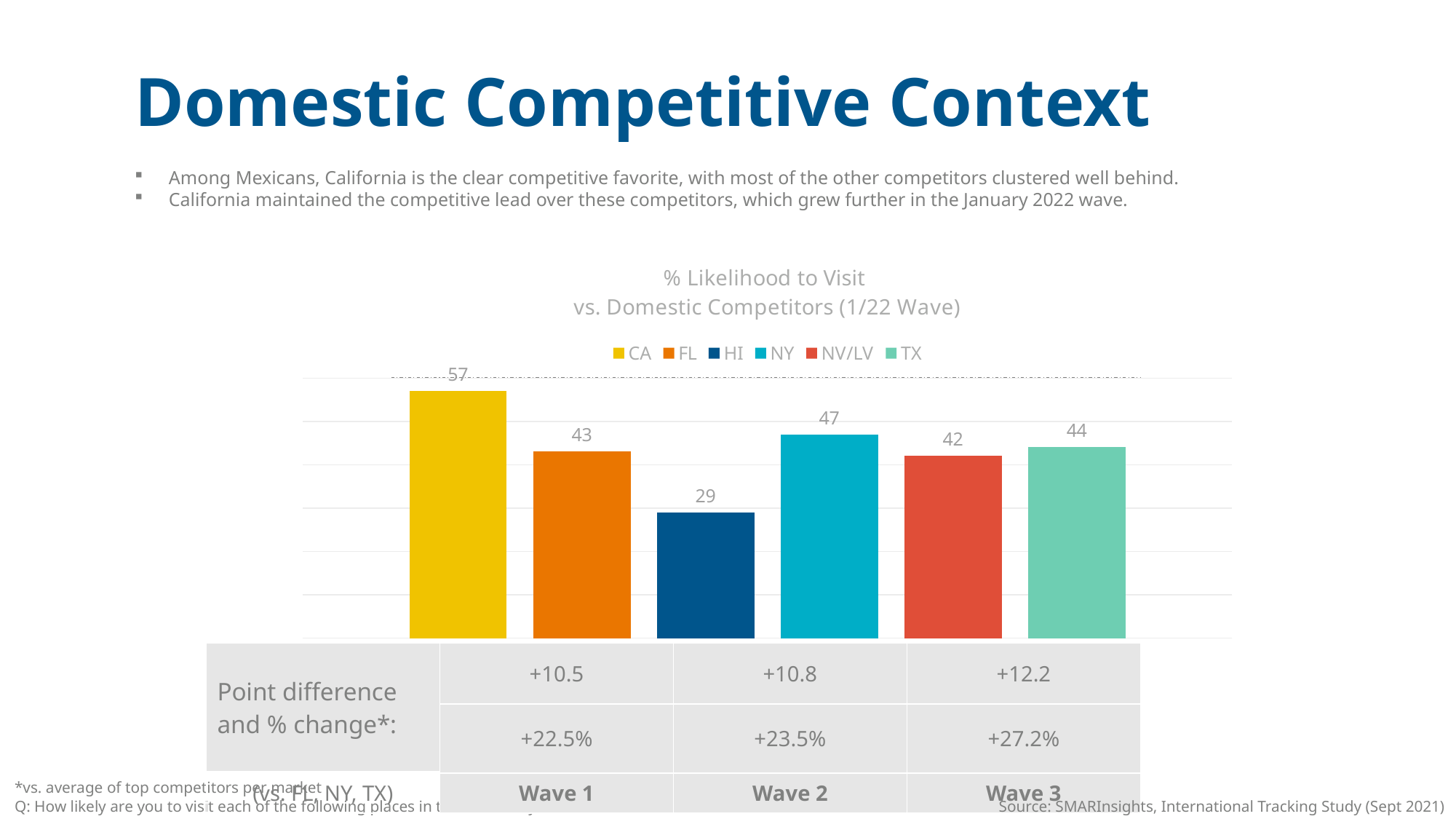
What is the % likelihood to visit value for CA? 57 What kind of chart is shown on the slide? Bar chart How many series does the legend list? 6 What is the % likelihood to visit value for HI? 29 What is the % likelihood to visit value for TX? 44 Which destination has the highest % likelihood to visit? CA What is the difference between the values for NY and HI? 18 Which destination has the lowest % likelihood to visit? HI How many destinations are shown in the chart? 6 What is the difference between the values for CA and FL? 14 What is the % likelihood to visit value for NY? 47 Which has a higher % likelihood to visit, NV/LV or TX? TX